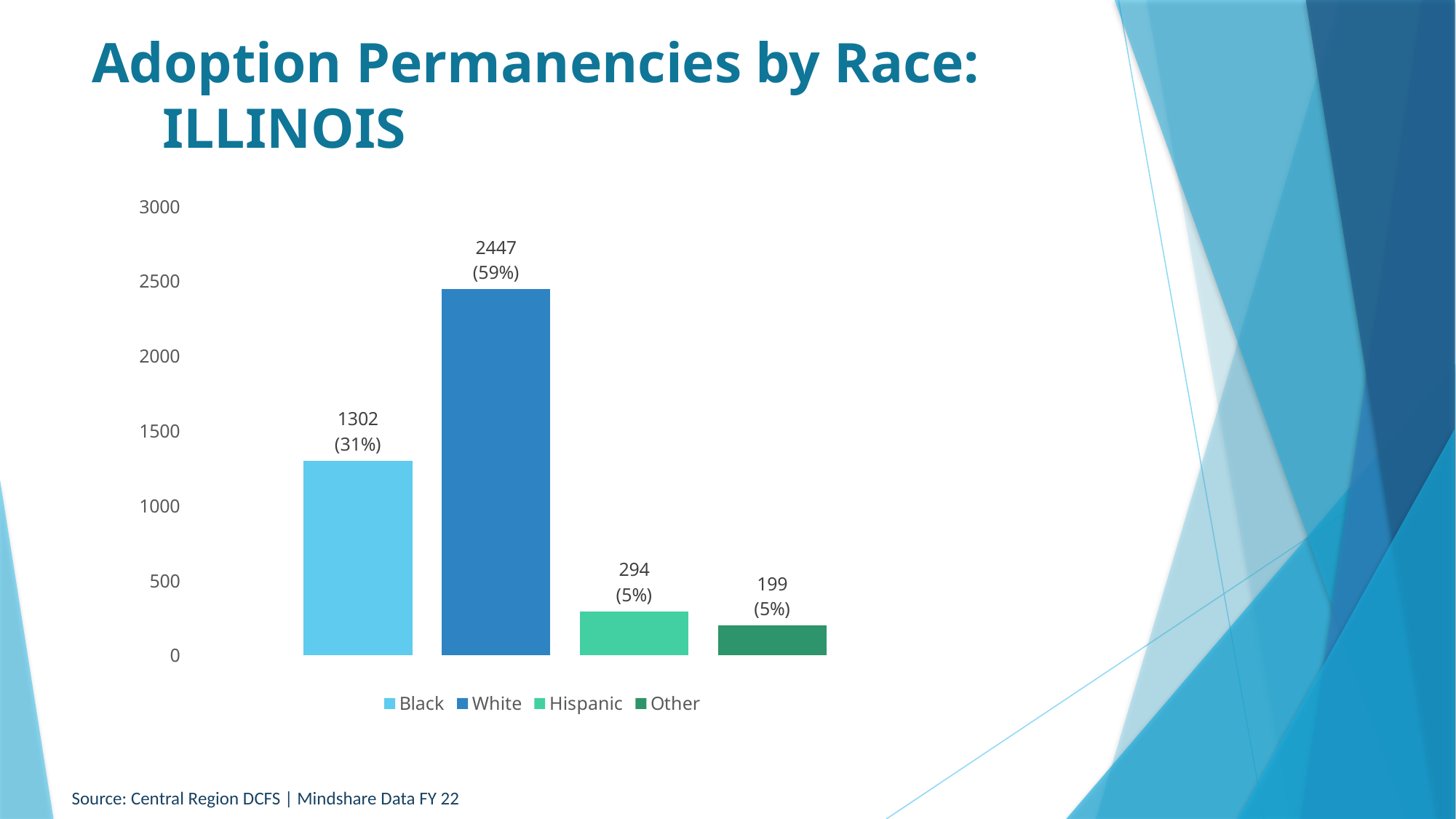
How many categories are shown in the chart? 4 Which category has the lowest value? Other Is the value for Black greater or less than 1000? greater What kind of chart is shown on the slide? Bar chart Which is larger, the value for Hispanic or the value for Other? Hispanic What is the value for Other? 199 (5%) What is the difference between the values for White and Black? 1145 Which category has the highest value? White What is the value for White? 2447 (59%) What is the value for Hispanic? 294 (5%) What is the value for Black? 1302 (31%) What is the title of the slide? Adoption Permanencies by Race: ILLINOIS